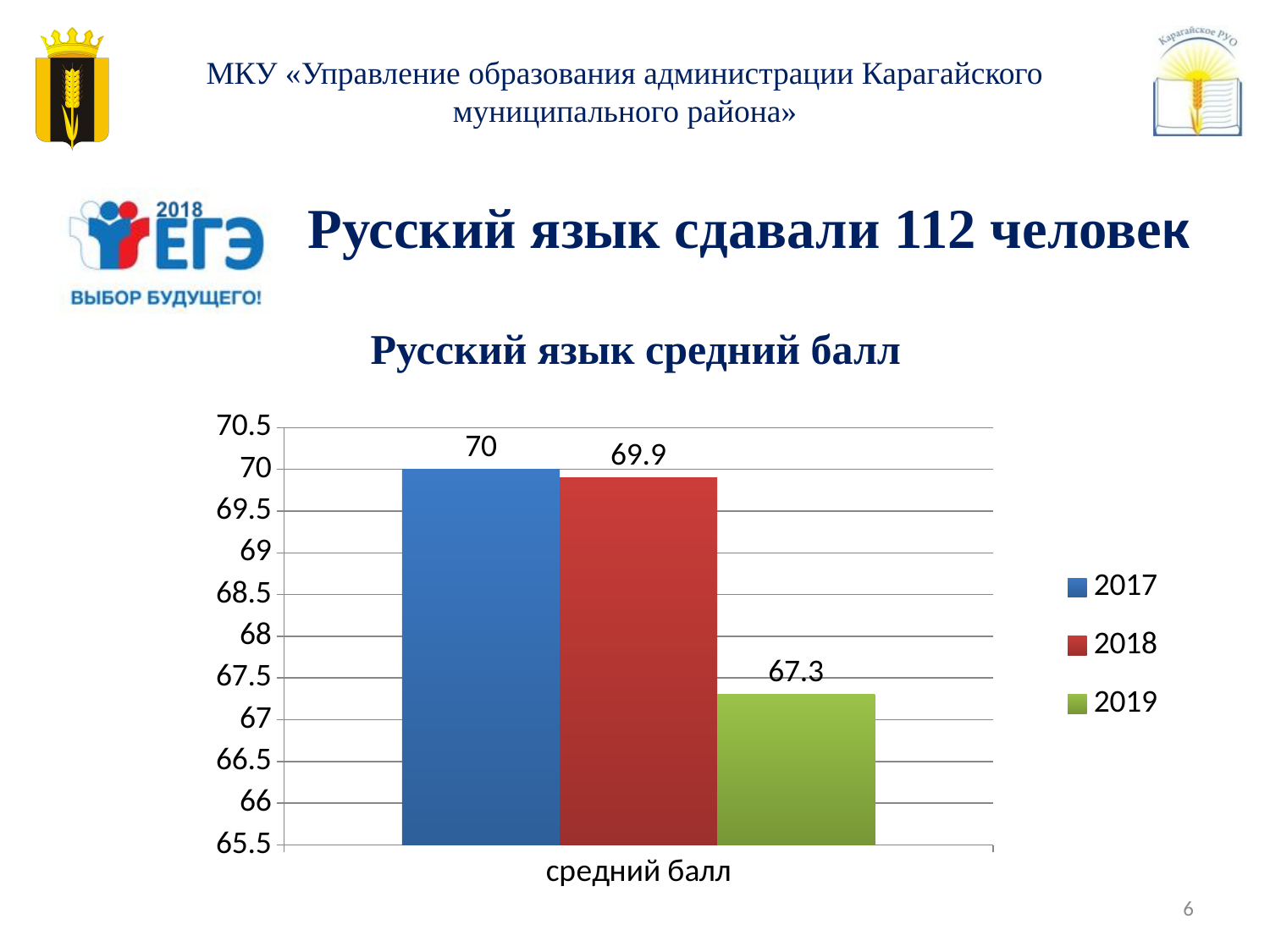
What is the title of the chart? Русский язык средний балл Is the value for 2019 greater or less than 68? less What is the average score for 2018? 69.9 Which is larger, the average score for 2018 or for 2019? 2018 What is the average score for 2019? 67.3 What kind of chart is shown on the slide? bar chart What is the difference between the average scores for 2018 and 2019? 2.6 What is the average score for 2017? 70 Which year has the lowest average score? 2019 How many series does the legend list? 3 Which year has the highest average score? 2017 What is the difference between the average scores for 2017 and 2019? 2.7